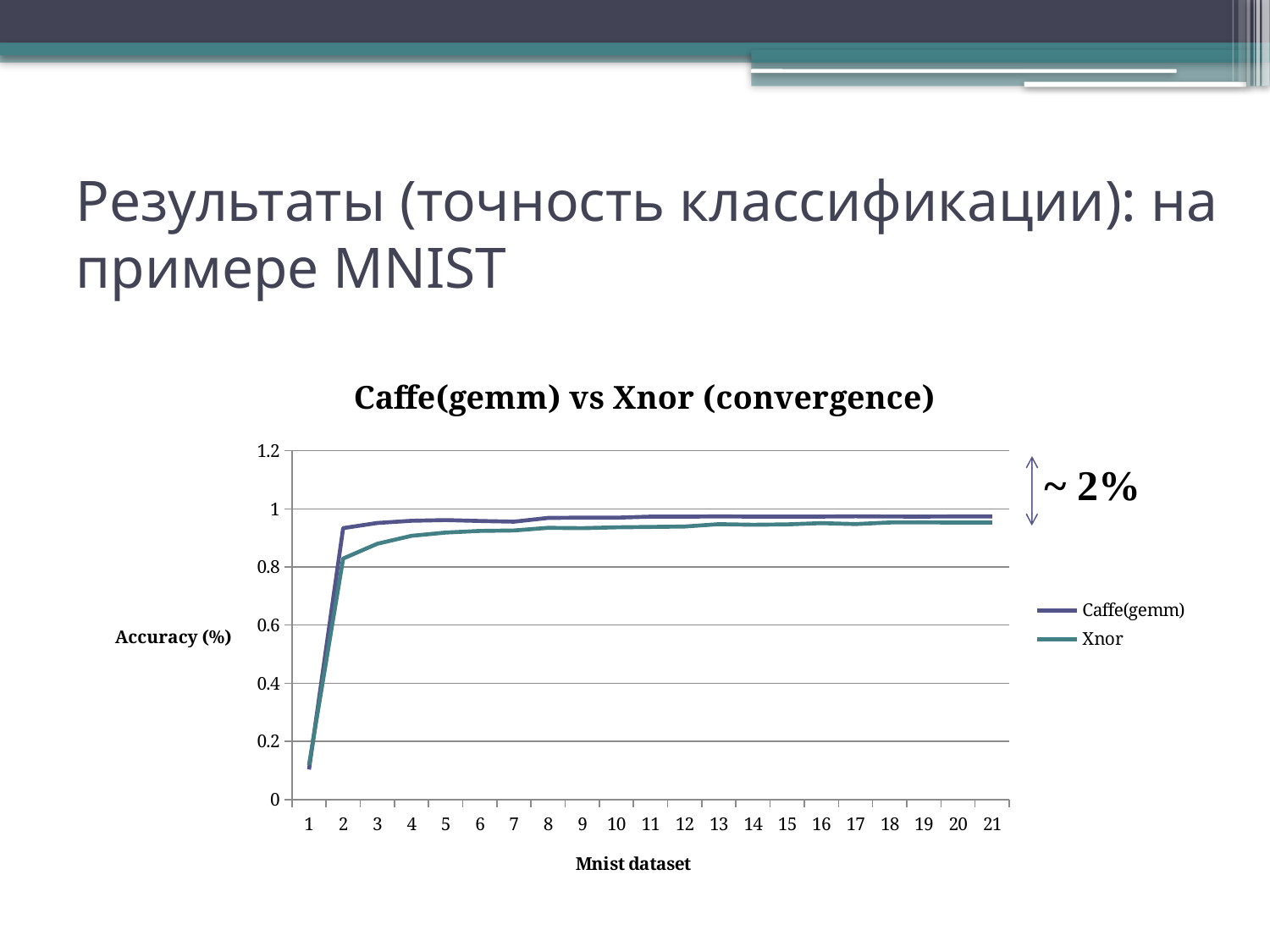
Is the value for Xnor at x = 21 greater or less than 0.8? greater How many series does the legend list? 2 Do the values of the Xnor series rise or fall along the x axis overall? rise What kind of chart is shown on the slide? line chart At x = 10, which series has the larger value, Caffe(gemm) or Xnor? Caffe(gemm) Is the value for Caffe(gemm) at x = 2 greater or less than 0.8? greater Is the value for Caffe(gemm) at x = 21 greater or less than 1? less What are the names of the two series in the legend? Caffe(gemm) and Xnor Do the values of the Caffe(gemm) series rise or fall along the x axis overall? rise What is the title of the chart? Caffe(gemm) vs Xnor (convergence) How many points are plotted along the x axis for each series? 21